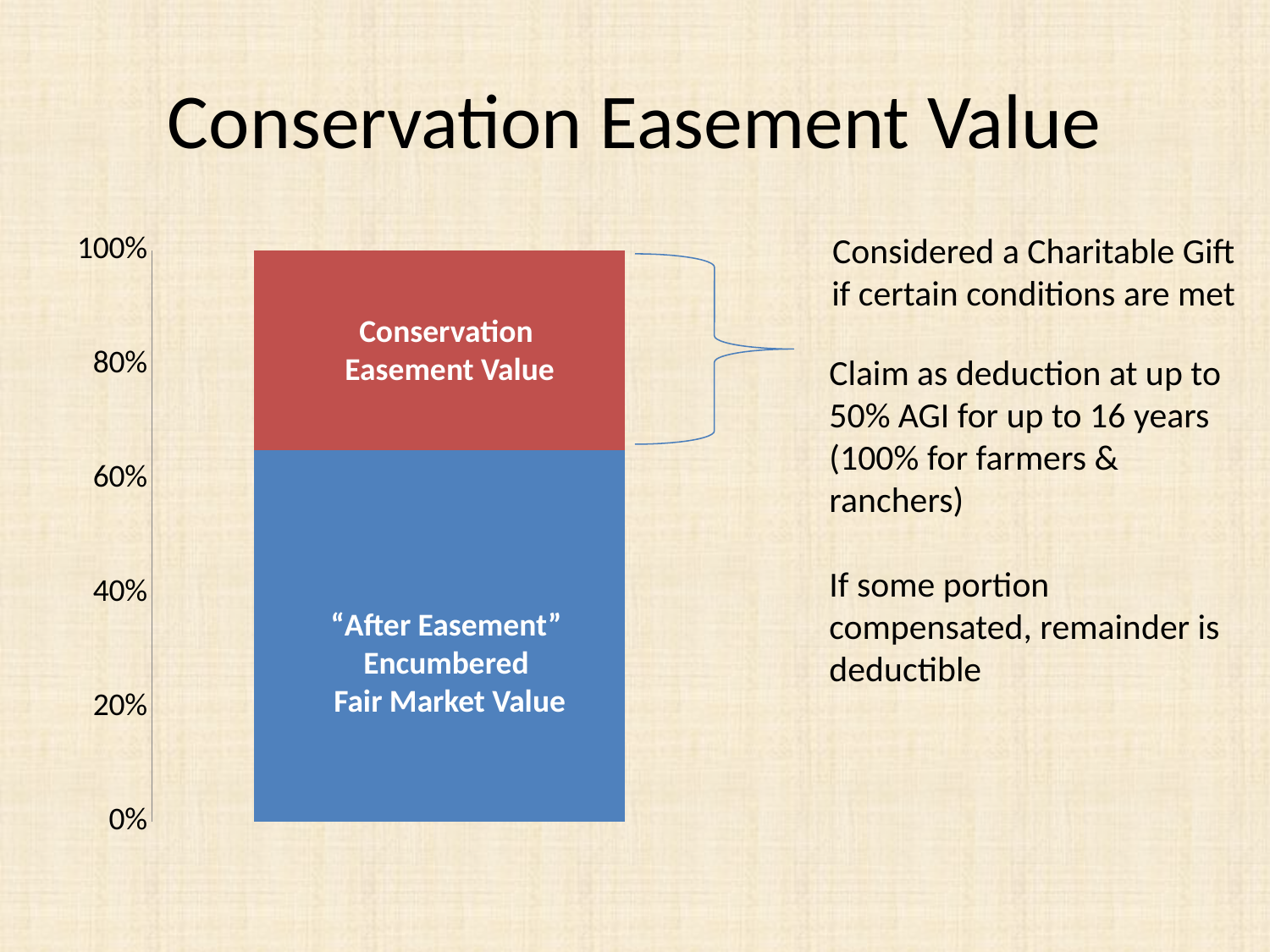
Is the value for "After Easement" Encumbered Fair Market Value greater or less than 80%? less Which segment of the bar is the smallest? Conservation Easement Value What colour is the Conservation Easement Value segment? Red Which segment of the bar is the largest? "After Easement" Encumbered Fair Market Value What kind of chart is shown on the slide? Stacked bar chart Is the value for "After Easement" Encumbered Fair Market Value greater or less than 60%? greater Which segment is larger, "After Easement" Encumbered Fair Market Value or Conservation Easement Value? "After Easement" Encumbered Fair Market Value How many bars does the chart contain? 1 What is the highest value shown on the vertical axis? 100% How many segments make up the stacked bar? 2 What is the total height of the stacked bar as read from the axis? 100% Is the value for Conservation Easement Value greater or less than 40%? less